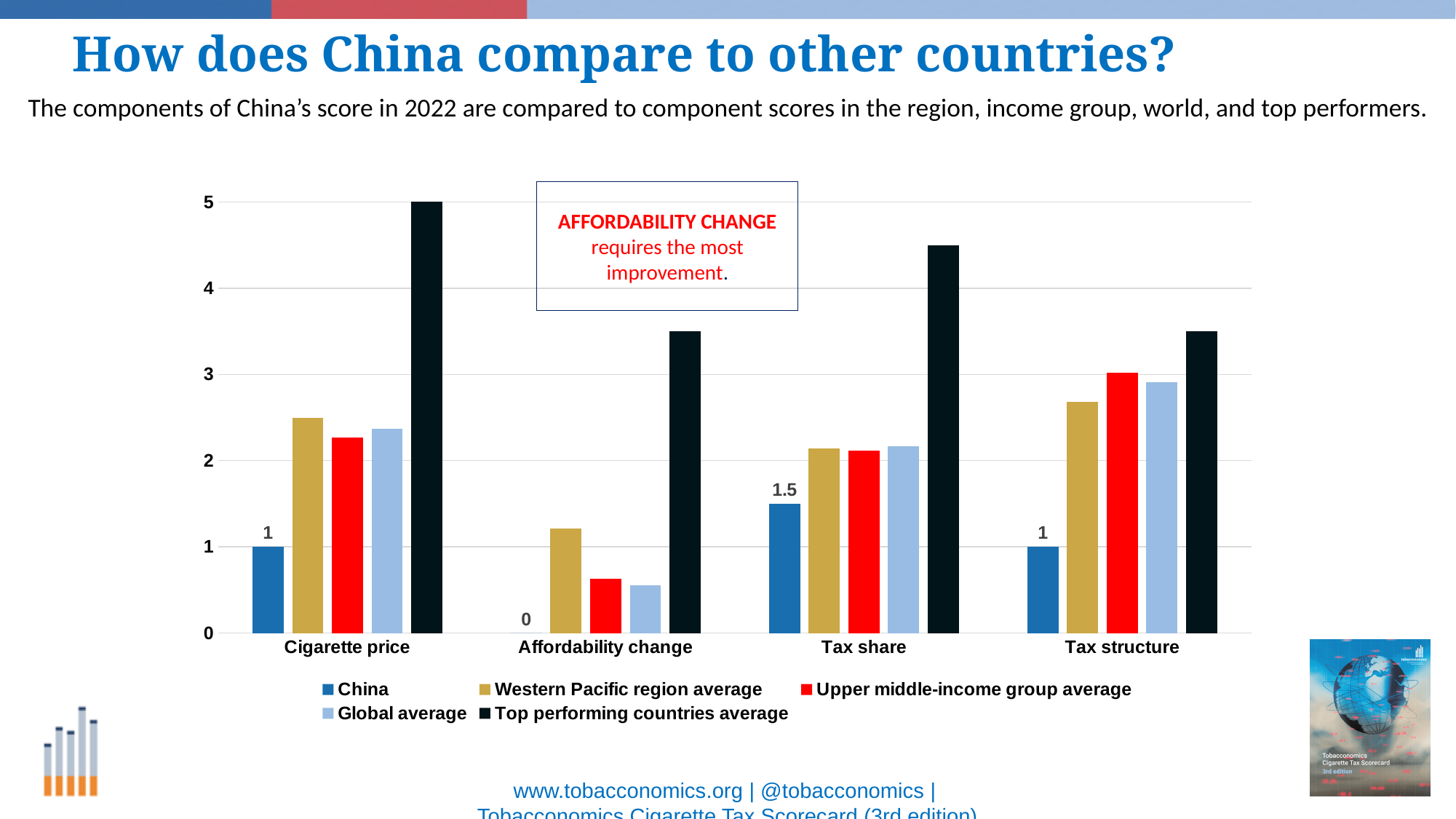
In which component does China have its highest score? Tax share In which component does China have its lowest score? Affordability change What is China's score for Tax share? 1.5 How many series does the legend list? 5 Is the Western Pacific region average for Affordability change greater or less than 2? less What is China's score for Affordability change? 0 Is the Top performing countries average for Tax share greater or less than 4? greater How many components (categories) are shown on the x axis? 4 What is the difference between China's Tax share score and its Cigarette price score? 0.5 What kind of chart is shown on the slide? Bar chart What is China's score for Cigarette price? 1 What is China's score for Tax structure? 1